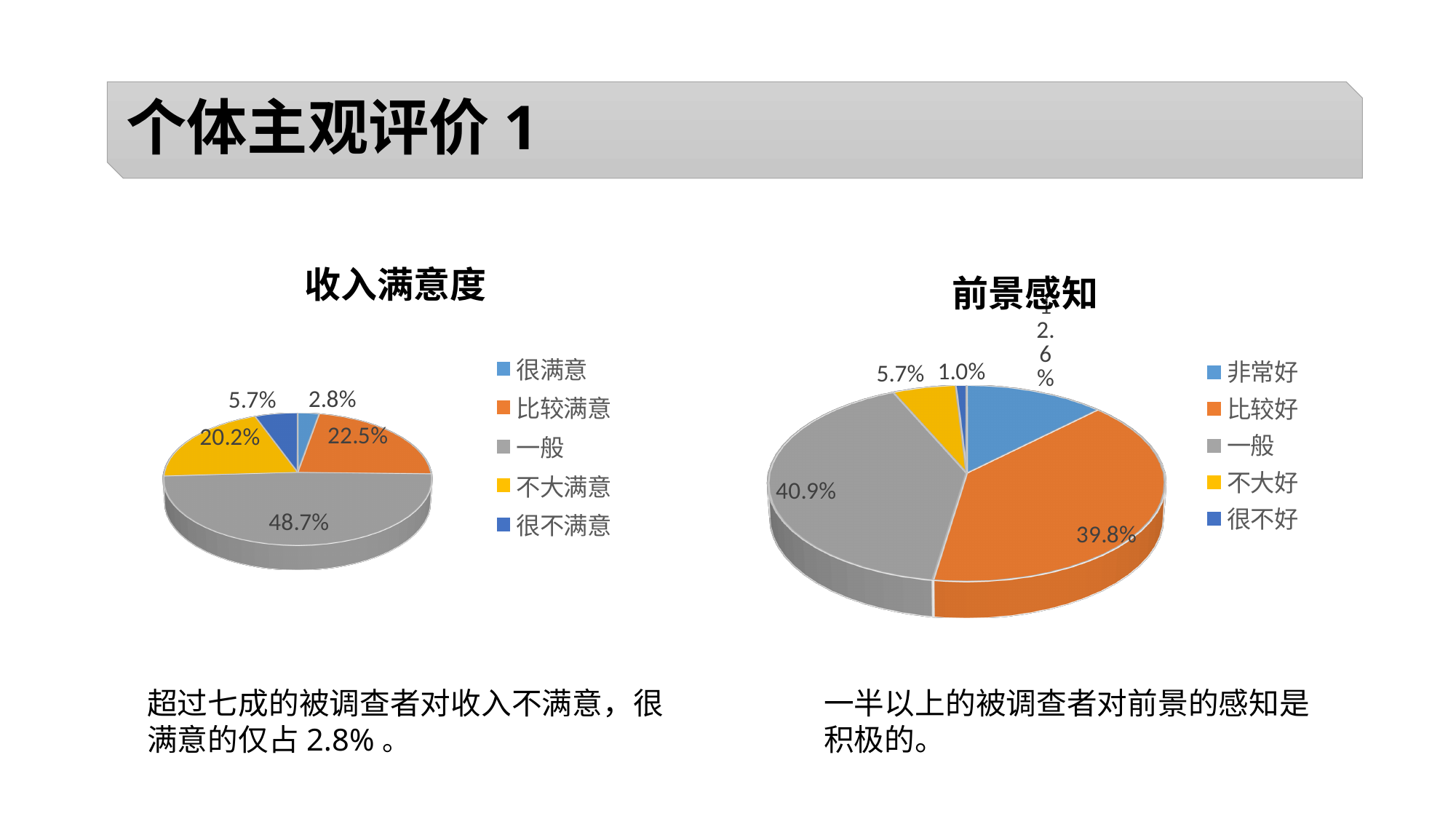
In the 收入满意度 chart, which category has the smallest slice? 很满意 In the 收入满意度 chart, which category has the largest slice? 一般 In the 收入满意度 chart, what share is labelled for 很满意? 2.8% In the 前景感知 chart, what share is labelled for 比较好? 39.8% In the 前景感知 chart, which colour represents 不大好? yellow How many categories does the legend of the 收入满意度 chart list? 5 In the 收入满意度 chart, what share is labelled for 一般? 48.7% In the 前景感知 chart, which is larger, the 一般 slice or the 比较好 slice? 一般 In the 收入满意度 chart, what share is labelled for 不大满意? 20.2% In the 前景感知 chart, what share is labelled for 很不好? 1.0% What type of chart is the 收入满意度 chart? pie chart In the 收入满意度 chart, what is the difference between the 比较满意 and 不大满意 shares? 2.3%